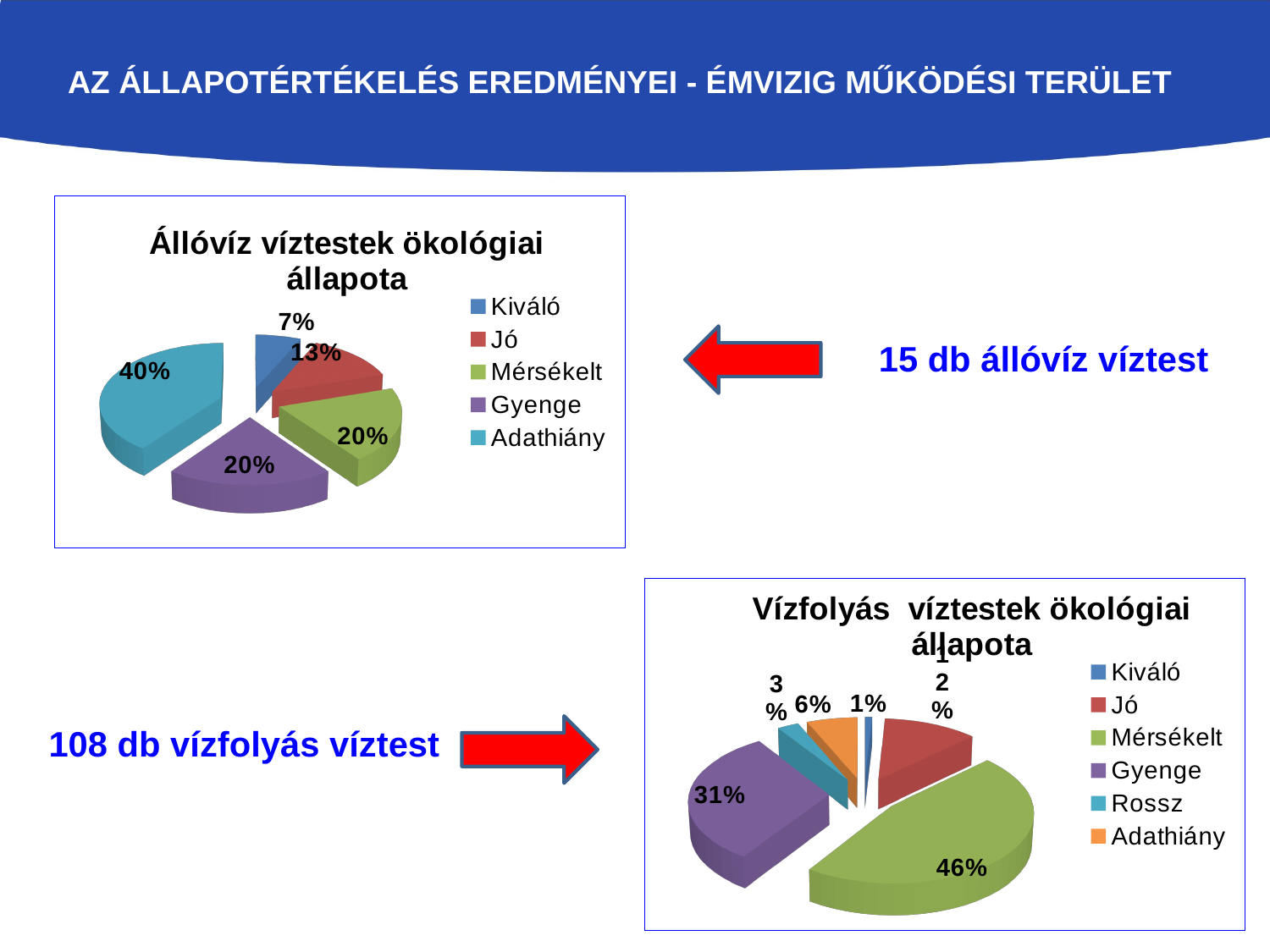
In the 'Állóvíz víztestek ökológiai állapota' chart, what share is labelled for Jó? 13% In the 'Vízfolyás víztestek ökológiai állapota' chart, what share is labelled for Gyenge? 31% In the 'Vízfolyás víztestek ökológiai állapota' chart, what share is labelled for Mérsékelt? 46% What type of chart is the 'Vízfolyás víztestek ökológiai állapota' chart? Pie chart In the 'Állóvíz víztestek ökológiai állapota' chart, what share is labelled for Kiváló? 7% In the 'Állóvíz víztestek ökológiai állapota' chart, what share is labelled for Adathiány? 40% In the 'Állóvíz víztestek ökológiai állapota' chart, which category has the largest slice? Adathiány In the 'Állóvíz víztestek ökológiai állapota' chart, which category has the smallest slice? Kiváló In the 'Vízfolyás víztestek ökológiai állapota' chart, which category has the largest slice? Mérsékelt How many categories does the legend of the 'Állóvíz víztestek ökológiai állapota' chart list? 5 In the 'Vízfolyás víztestek ökológiai állapota' chart, is the slice for Gyenge or Adathiány larger? Gyenge In the 'Állóvíz víztestek ökológiai állapota' chart, what is the difference in percentage points between Adathiány and Jó? 27